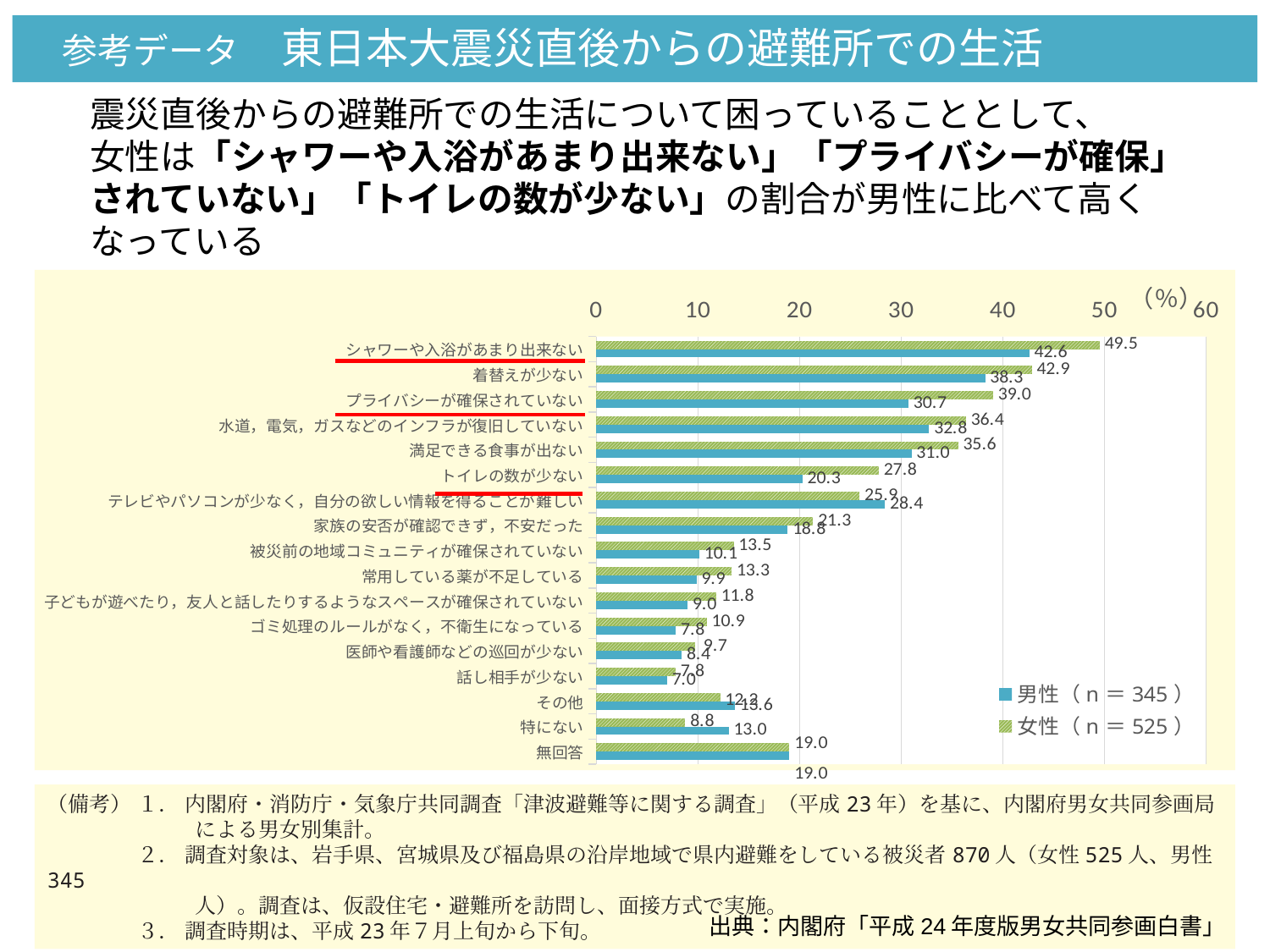
「トイレの数が少ない」の女性と男性の値の差はいくつですか？ 7.5 「テレビやパソコンが少なく，自分の欲しい情報を得ることが難しい」では、男性と女性のどちらの値が大きいですか？ 男性 これはどの種類のグラフですか？ 棒グラフ 「プライバシーが確保されていない」の男性の値はいくつですか？ 30.7 「着替えが少ない」の女性の値は40より大きいですか、小さいですか？ 大きい このグラフには項目がいくつありますか？ 17 凡例にはいくつの系列が示されていますか？ 2 「シャワーや入浴があまり出来ない」の女性の値はいくつですか？ 49.5 男性の系列で最も値が低い項目はどれですか？ 話し相手が少ない 「トイレの数が少ない」の女性の値はいくつですか？ 27.8 女性の系列で最も値が高い項目はどれですか？ シャワーや入浴があまり出来ない 凡例に示されている女性の回答者数（n）はいくつですか？ 525